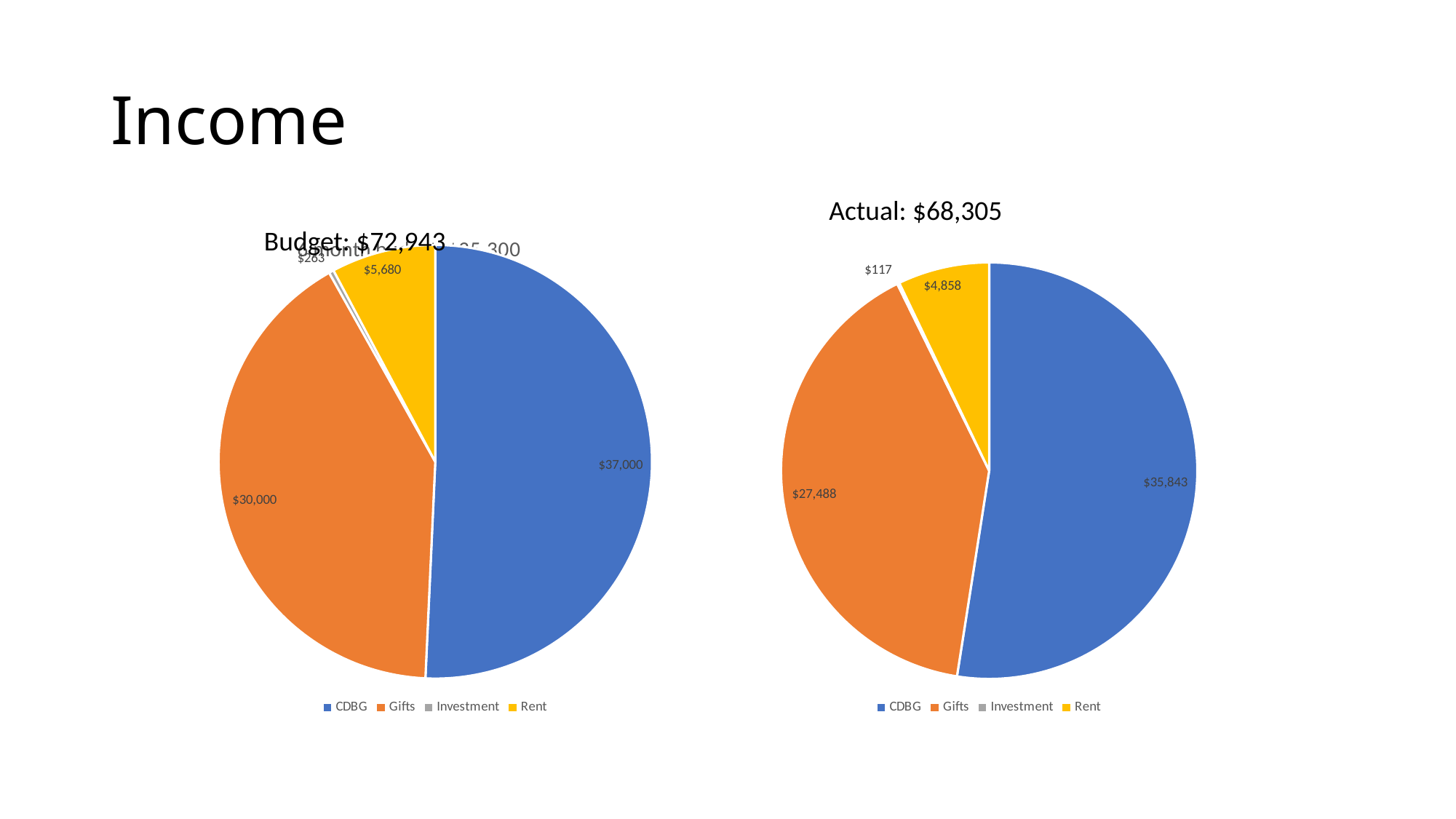
In the Actual pie chart, what is the value for Rent? $4,858 In the Actual pie chart, which category has the largest slice? CDBG In the Budget pie chart, what is the difference between CDBG and Gifts? $7,000 In the Actual pie chart, which category has the smallest slice? Investment In the Actual pie chart, what is the value for Investment? $117 In the Budget pie chart, what is the value for CDBG? $37,000 In the Actual pie chart, what is the difference between CDBG and Gifts? $8,355 In the Budget pie chart, what is the value for Rent? $5,680 How many categories does the legend of the Actual pie chart list? 4 What type of chart is used on this slide? Pie chart In the Budget pie chart, what is the value for Gifts? $30,000 In the Actual pie chart, what is the value for CDBG? $35,843